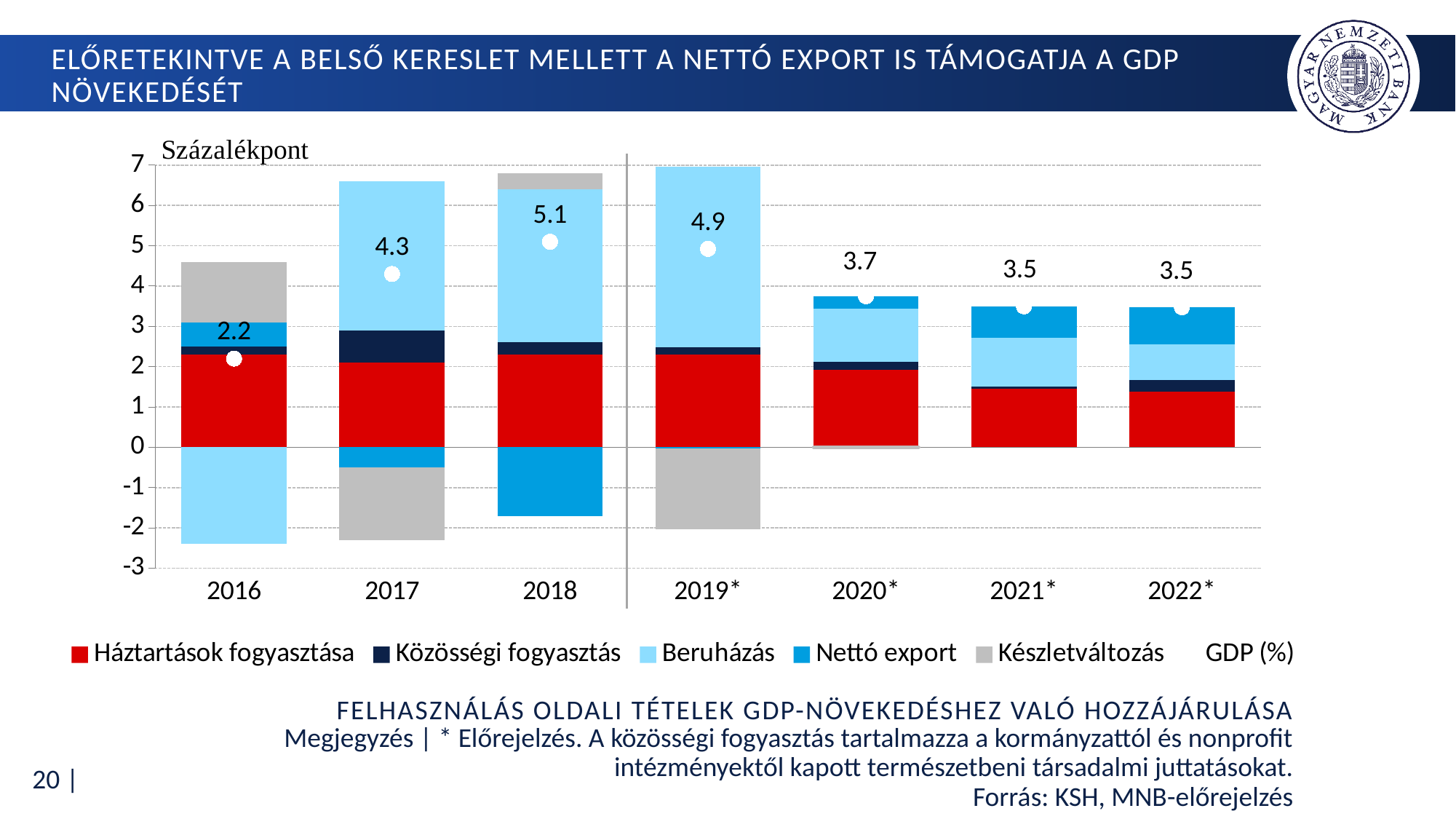
How many years are shown on the x axis? 7 Which year has a larger GDP (%) value, 2019* or 2020*? 2019* Is the Beruházás value for 2016 greater or less than 0? less In which year is the GDP (%) value the highest? 2018 What is the difference between the GDP (%) values for 2018 and 2017? 0.8 In which year is the GDP (%) value the lowest? 2016 What is the GDP (%) value shown for 2018? 5.1 What is the GDP (%) value shown for 2020*? 3.7 What is the GDP (%) value shown for 2016? 2.2 Is the Készletváltozás value for 2019* greater or less than -1? less How many entries does the legend list? 6 Does the GDP (%) value rise or fall from 2019* to 2022*? fall